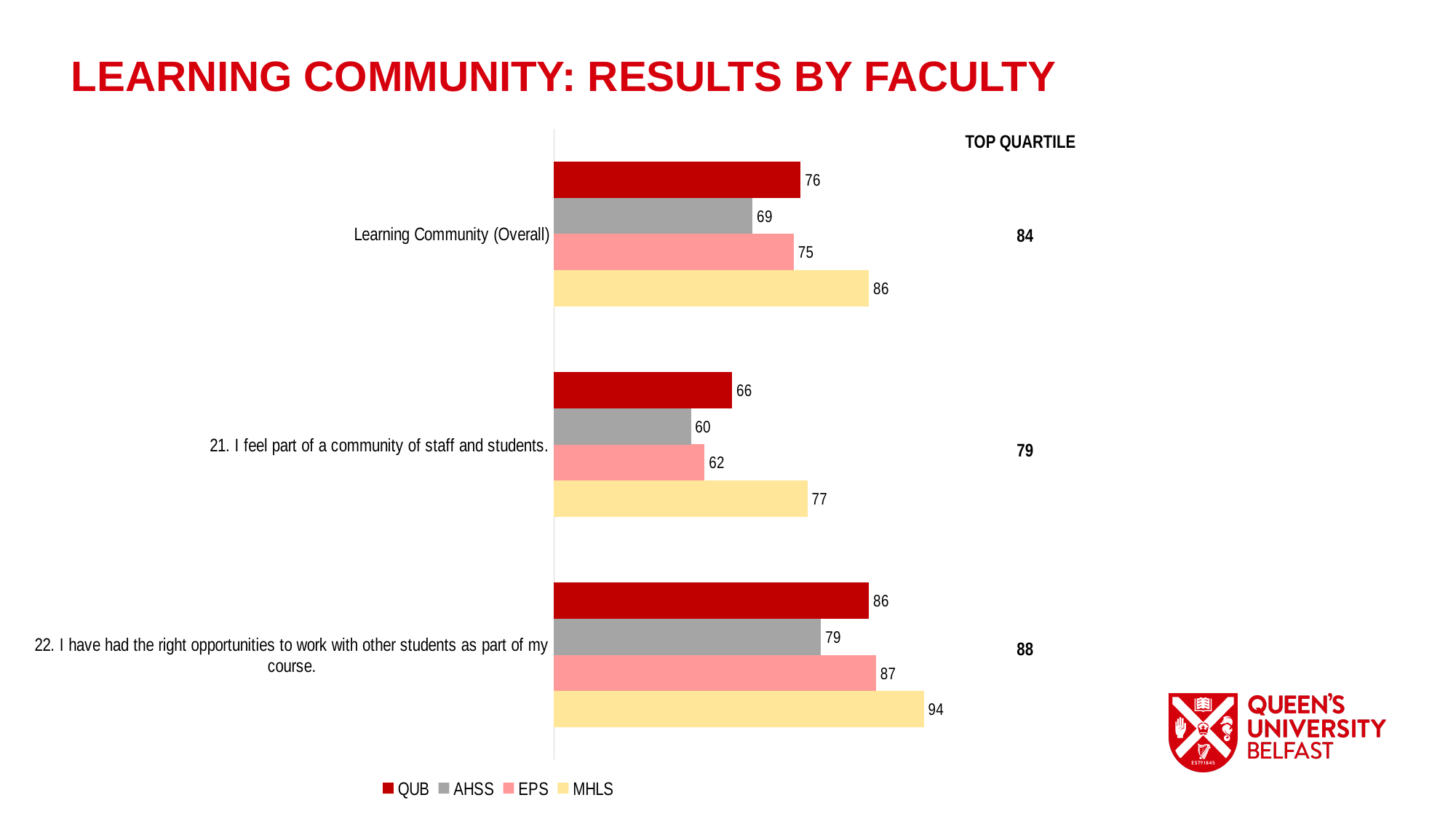
Which series has the lowest value for question 22, 'I have had the right opportunities to work with other students as part of my course'? AHSS What is the Top Quartile value shown for Learning Community (Overall)? 84 What is the AHSS value for question 21, 'I feel part of a community of staff and students'? 60 Which is larger for question 22: the QUB value or the EPS value? EPS What is the QUB value for Learning Community (Overall)? 76 What is the EPS value for Learning Community (Overall)? 75 How many series does the legend list? 4 Which series has the highest value for question 21, 'I feel part of a community of staff and students'? MHLS What is the MHLS value for question 22, 'I have had the right opportunities to work with other students as part of my course'? 94 How many categories are shown on the chart? 3 What is the difference between the MHLS and AHSS values for Learning Community (Overall)? 17 What kind of chart is shown on the slide? Bar chart